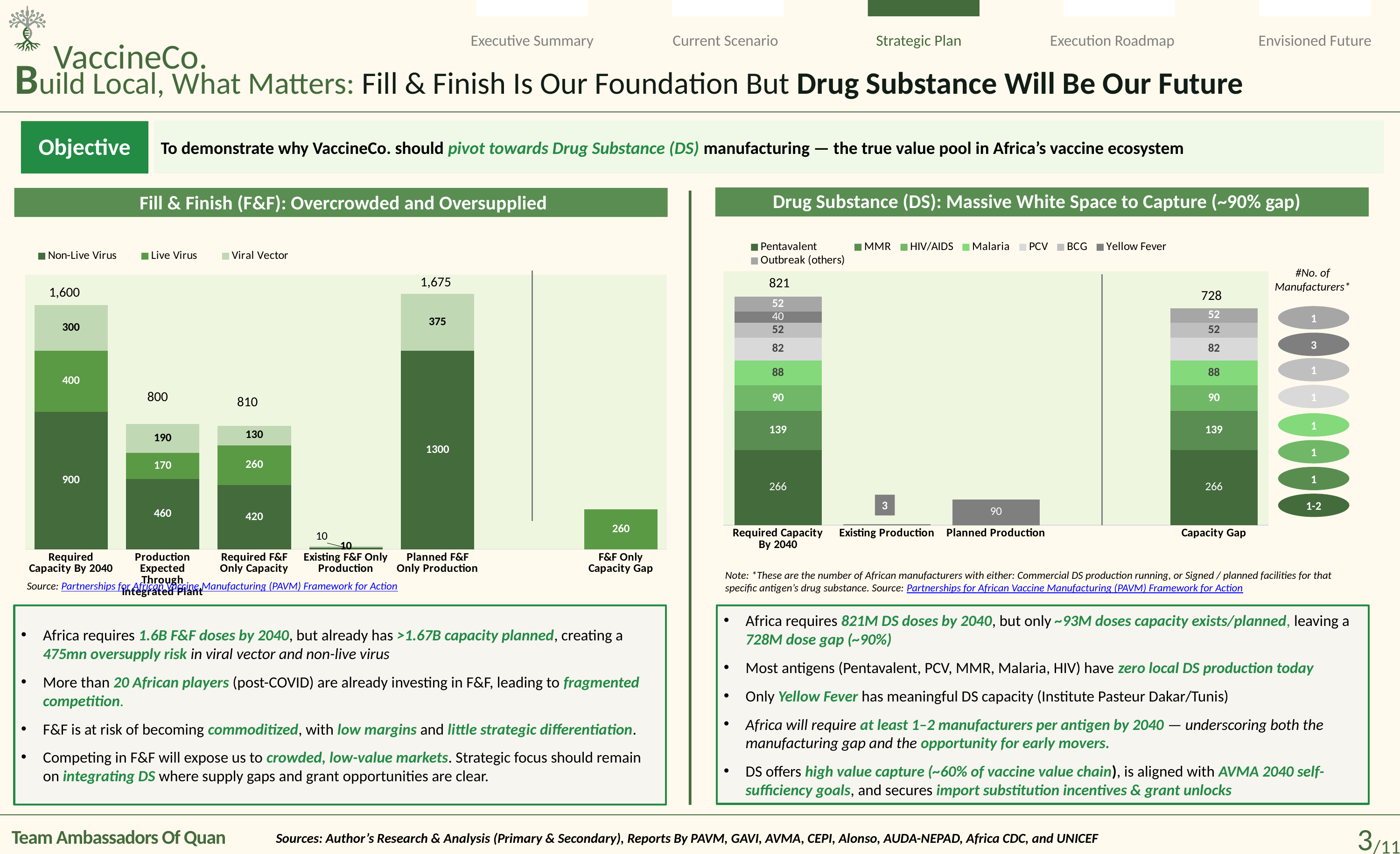
In the Drug Substance (DS) chart, what is the Pentavalent value for Required Capacity By 2040? 266 How many series does the legend of the Drug Substance (DS) chart list? 8 In the Fill & Finish (F&F) chart, which category has the highest total value? Planned F&F Only Production In the Drug Substance (DS) chart, what is the total value shown for the Capacity Gap bar? 728 In the Fill & Finish (F&F) chart, what is the Non-Live Virus value for Planned F&F Only Production? 1300 In the Fill & Finish (F&F) chart, what is the total value shown for the Required Capacity By 2040 bar? 1,600 In the Fill & Finish (F&F) chart, what is the difference between the Non-Live Virus values for Required Capacity By 2040 and Required F&F Only Capacity? 480 In the Fill & Finish (F&F) chart, what is the value of the F&F Only Capacity Gap bar? 260 What type of chart is the Drug Substance (DS) chart? Stacked bar chart In the Drug Substance (DS) chart, which is larger: Existing Production or Planned Production? Planned Production How many series does the legend of the Fill & Finish (F&F) chart list? 3 In the Fill & Finish (F&F) chart, which category has the lowest value? Existing F&F Only Production